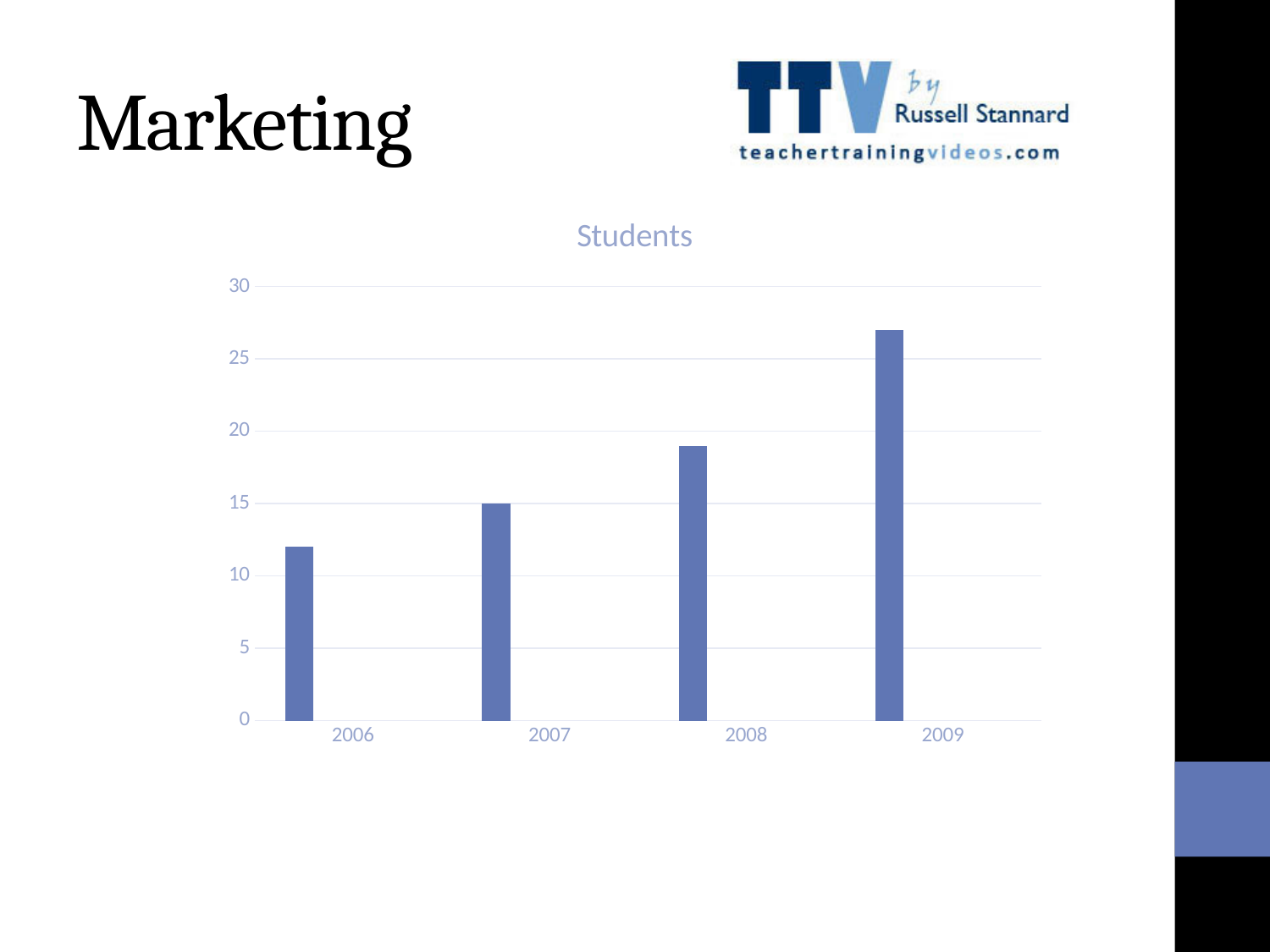
Is the value for 2009 greater or less than 25? greater What is the title of the chart? Students Is the value for 2006 greater or less than 10? greater Which is larger, the value for 2008 or the value for 2006? 2008 What kind of chart is shown on the slide? bar chart Which year has the lowest value in the Students chart? 2006 How many years are shown on the x axis of the Students chart? 4 Do the values rise or fall from 2006 to 2009? rise What is the value for 2007 in the Students chart? 15 What is the highest value shown on the y axis of the Students chart? 30 Which year has the highest value in the Students chart? 2009 Is the value for 2008 greater or less than 20? less